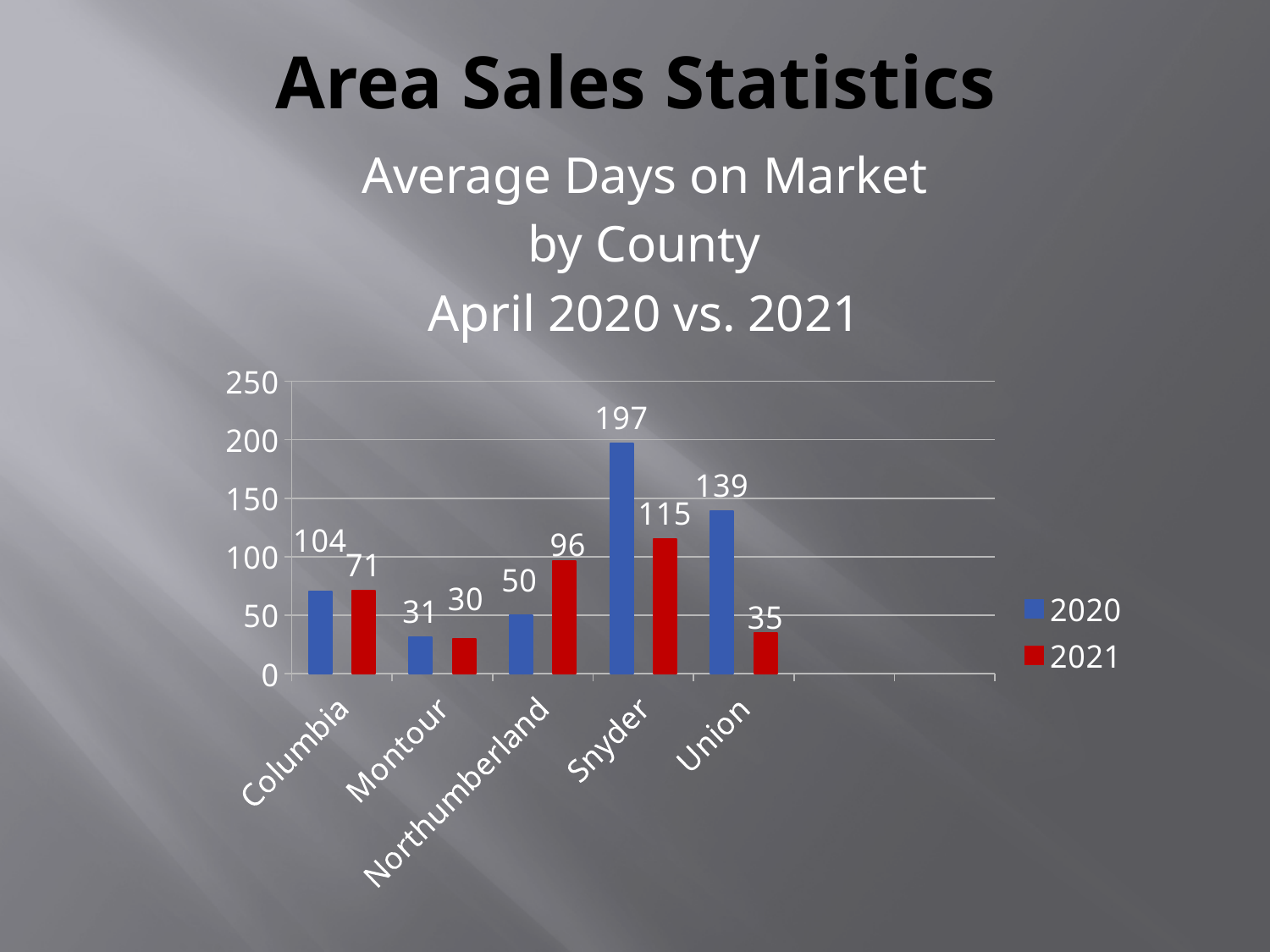
How many counties are shown on the chart? 5 Which county had the lowest average days on market in 2021? Montour What was the average days on market for Union in 2021? 35 Which county had the highest average days on market in 2020? Snyder What was the average days on market for Snyder in 2020? 197 What was the average days on market for Northumberland in 2021? 96 Which is larger for Northumberland, the 2020 value or the 2021 value? 2021 What was the average days on market for Montour in 2020? 31 What is the difference between Union's 2020 and 2021 average days on market? 104 How many series does the legend list? 2 What is the difference between Snyder's 2020 and 2021 average days on market? 82 What type of chart is shown on the slide? Bar chart